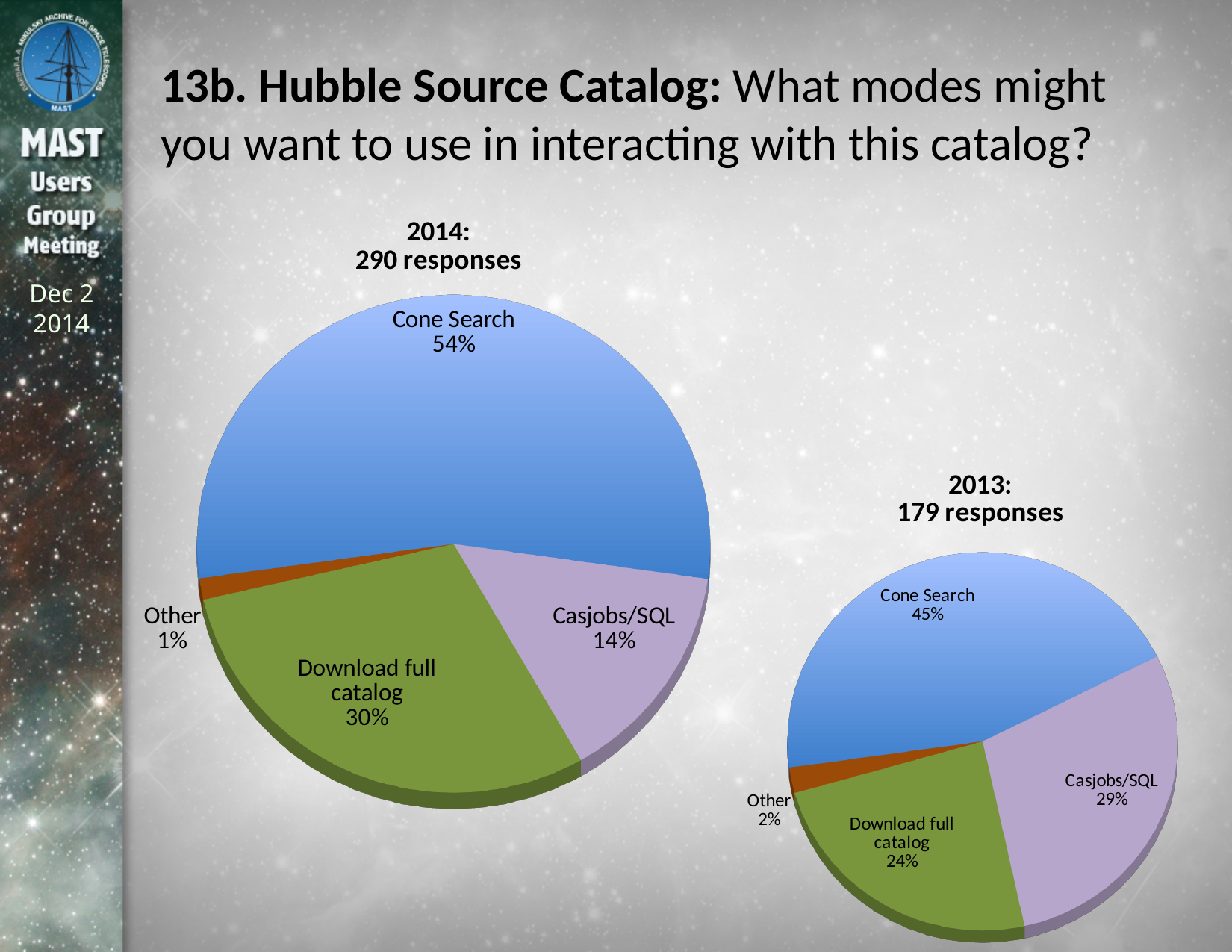
How many categories are shown in the 2014 pie chart? 4 In the 2013 pie chart, which is larger: Casjobs/SQL or Download full catalog? Casjobs/SQL In the 2013 pie chart, which category has the smallest share? Other In the 2014 pie chart, which category has the largest share? Cone Search What is the difference between the Casjobs/SQL share in the 2013 chart and in the 2014 chart? 15% What kind of chart is used for the 2013 data? Pie chart In the 2013 pie chart, what share does Casjobs/SQL have? 29% In the 2013 pie chart, what share does Other have? 2% In the 2014 pie chart, what share does Cone Search have? 54% In the 2014 pie chart, what is the combined share of Cone Search and Download full catalog? 84% In the 2014 pie chart, what share does Download full catalog have? 30% How many responses does the 2014 chart's title say it is based on? 290 responses